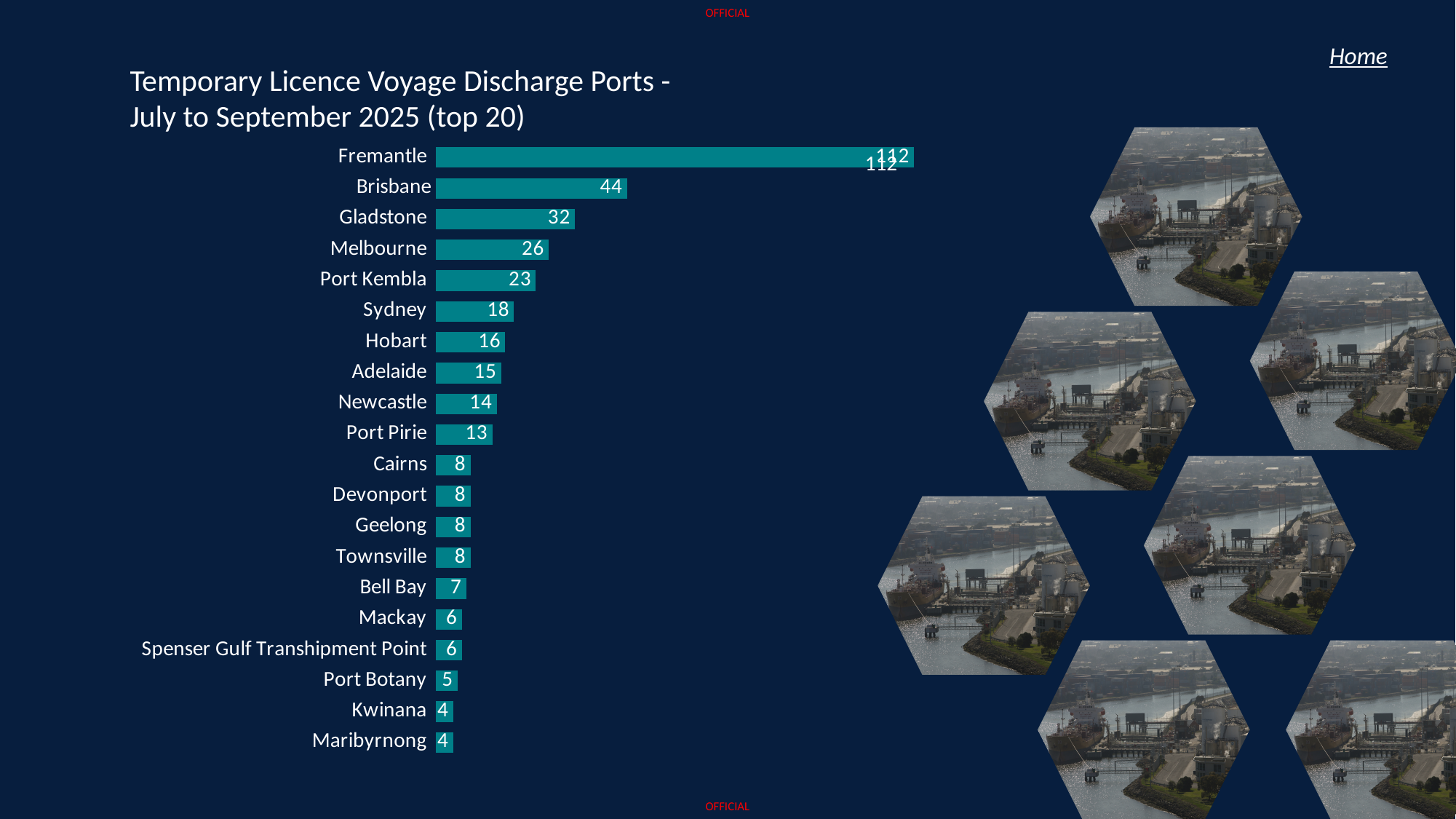
What is the value for Port Kembla? 23 What kind of chart is shown on the slide? Bar chart What is the difference between the values for Gladstone and Melbourne? 6 How many ports are shown in the chart? 20 What is the title of the chart? Temporary Licence Voyage Discharge Ports - July to September 2025 (top 20) Which has a larger value, Sydney or Hobart? Sydney Which has a larger value, Port Pirie or Newcastle? Newcastle What is the difference between the values for Fremantle and Brisbane? 68 Which port has the highest value? Fremantle What is the value for Fremantle? 112 What is the value for Spenser Gulf Transhipment Point? 6 What is the value for Brisbane? 44